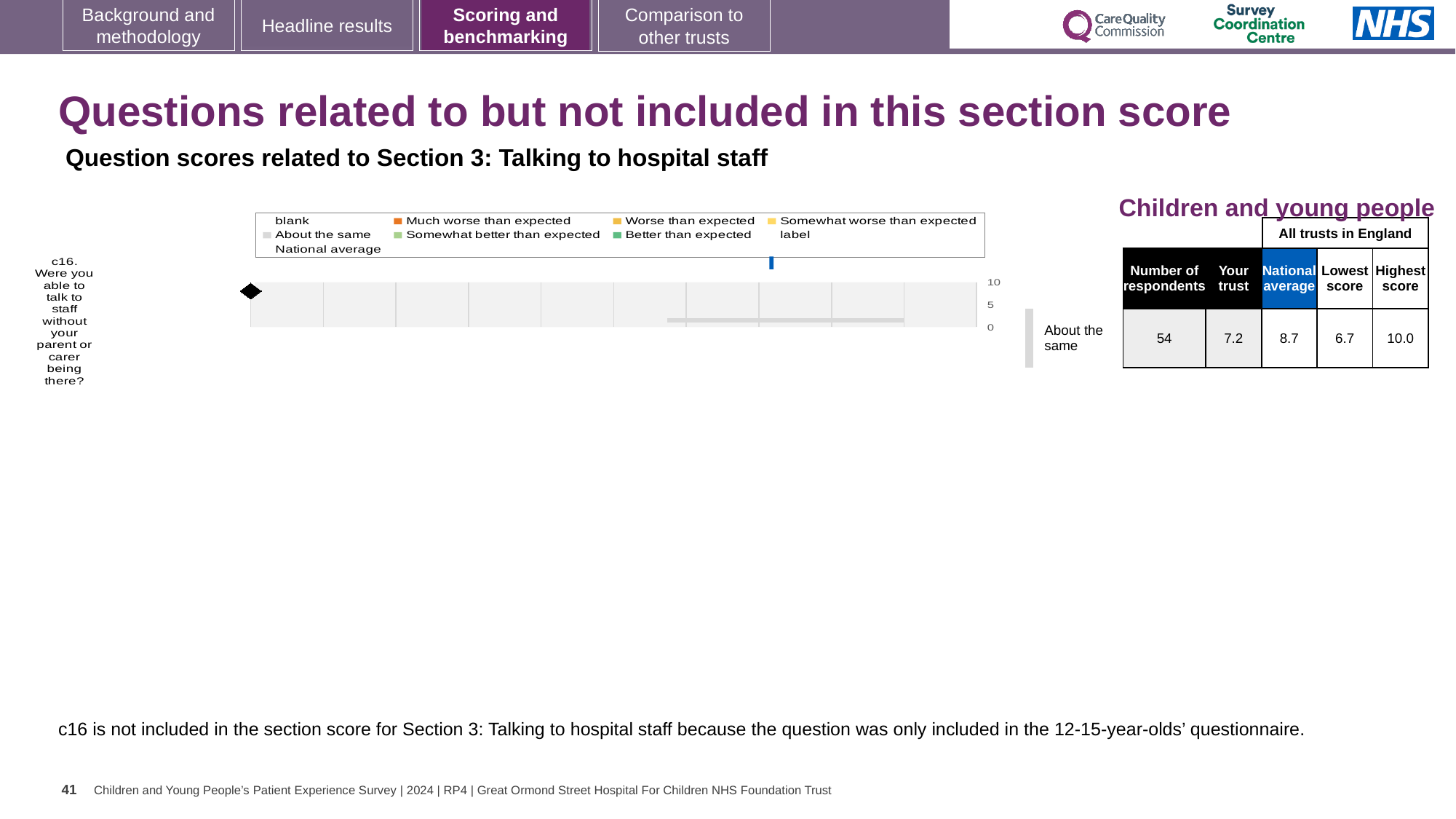
Which is larger for c16: the 'Your trust' score or the national average? National average Which question is plotted on the chart? c16. Were you able to talk to staff without your parent or carer being there? According to the table next to the chart, what is the lowest score among all trusts in England for c16? 6.7 According to the table next to the chart, what is the highest score among all trusts in England for c16? 10.0 What kind of chart is shown on the slide? bar chart What is the difference between the national average (8.7) and the 'Your trust' score (7.2) for c16? 1.5 According to the table next to the chart, what is the national average score for c16? 8.7 How many respondents answered question c16, according to the table next to the chart? 54 According to the table next to the chart, what is the 'Your trust' score for c16? 7.2 What is the highest value shown on the chart's axis? 10 How many questions (categories) are plotted on the chart? 1 What benchmark category is the trust's c16 result labelled as next to the chart? About the same